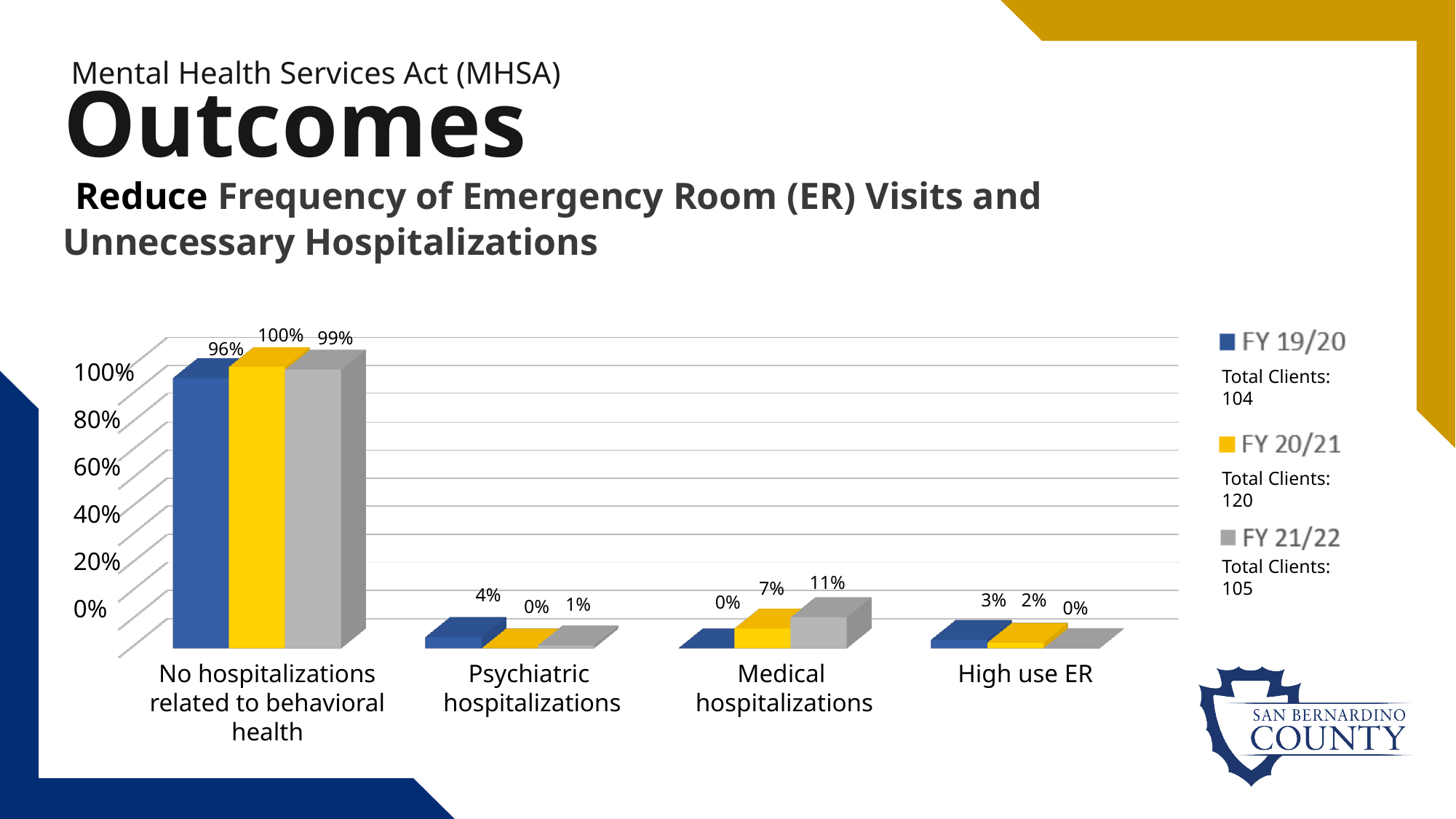
What is the difference between the FY 21/22 and FY 20/21 values for 'Medical hospitalizations'? 4% Which is larger for 'Psychiatric hospitalizations': the FY 19/20 value or the FY 21/22 value? FY 19/20 What is the value for FY 19/20 in the 'No hospitalizations related to behavioral health' category? 96% What kind of chart is shown on the slide? Bar chart Which fiscal year has the lowest value for 'Medical hospitalizations'? FY 19/20 How many series does the legend list? 3 Which fiscal year has the highest value for 'No hospitalizations related to behavioral health'? FY 20/21 According to the legend, how many total clients were there in FY 20/21? 120 What is the value for FY 21/22 in the 'Medical hospitalizations' category? 11% What is the value for FY 20/21 in the 'Psychiatric hospitalizations' category? 0% What is the value for FY 19/20 in the 'High use ER' category? 3% How many categories are shown on the x axis of the chart? 4